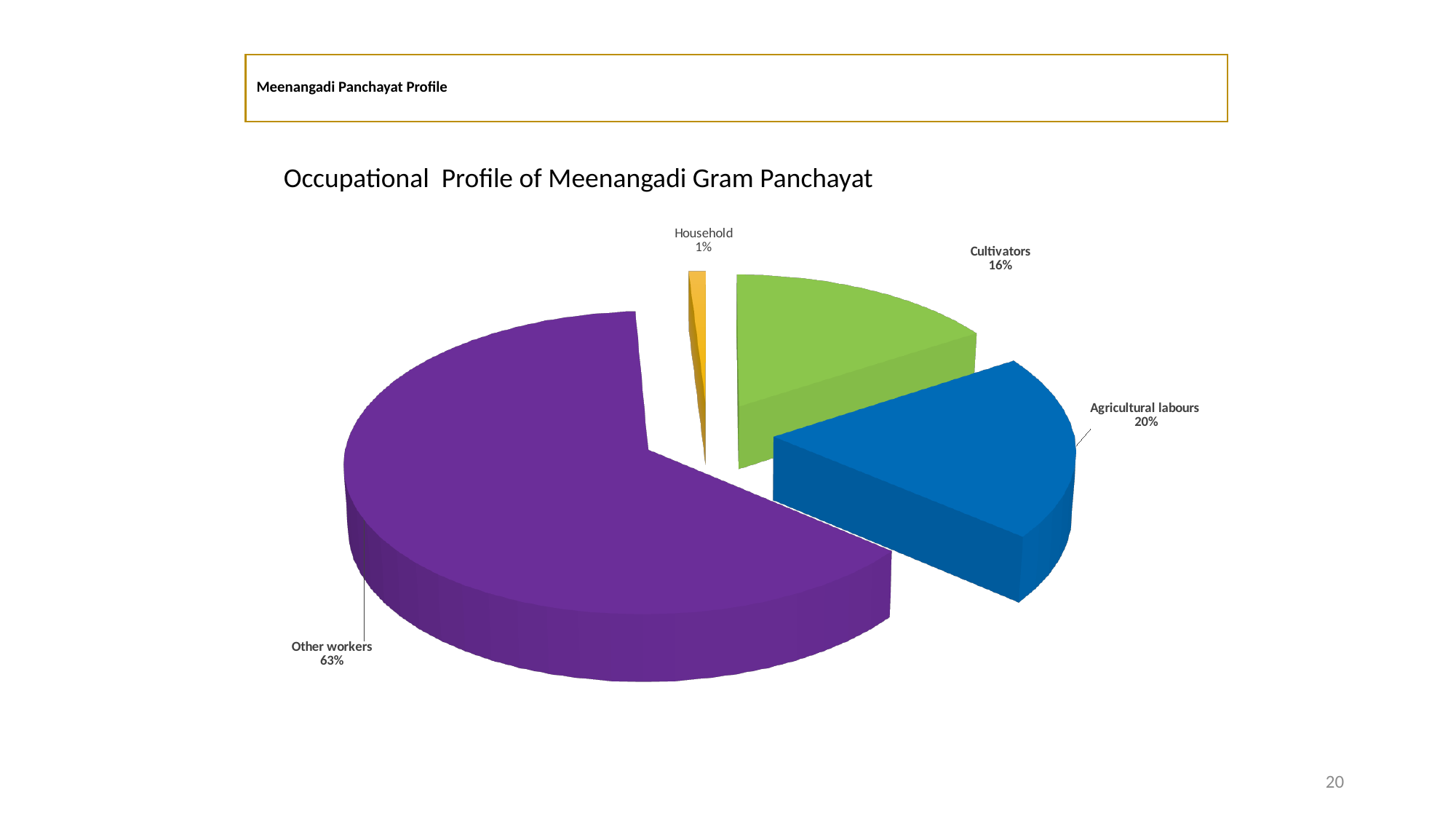
How many categories are shown in the pie chart? 4 What is the value shown for Agricultural labours? 20% Which category has the largest slice of the pie? Other workers What is the value shown for Cultivators? 16% Which is larger, the share for Cultivators or the share for Agricultural labours? Agricultural labours What is the value shown for Household? 1% What is the title of the chart? Occupational Profile of Meenangadi Gram Panchayat What is the difference in percentage points between Agricultural labours and Cultivators? 4 Which category has the smallest slice of the pie? Household What kind of chart is shown on the slide? Pie chart What colour is the slice for Other workers? Purple What share of the pie does Other workers hold? 63%